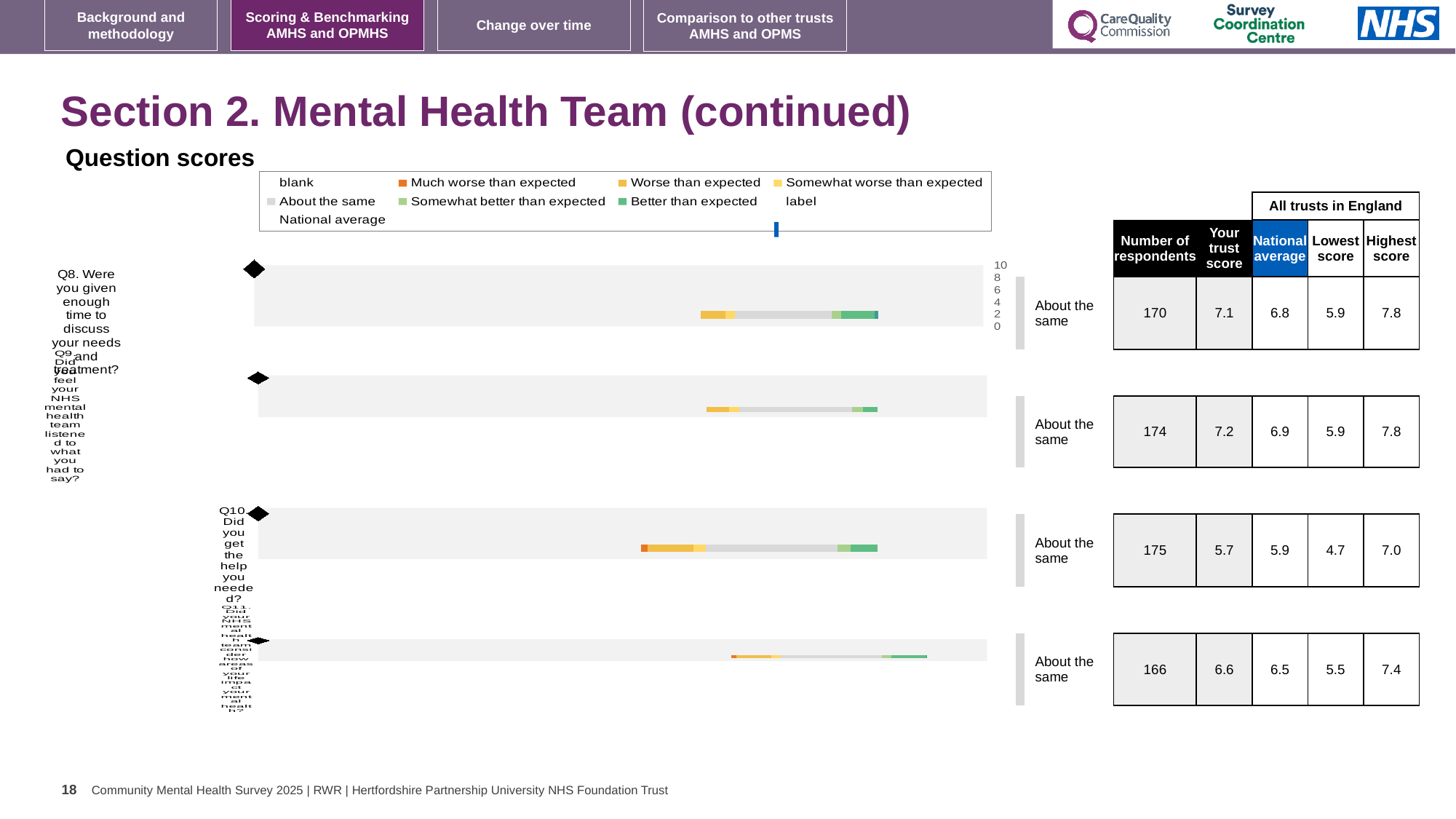
What benchmark label is shown next to the bar for Q8? About the same Which question numbers are plotted in the 'Question scores' chart? Q8, Q9, Q10, Q11 What is the highest tick value shown on the chart's axis? 10 What colour does the legend use for 'Much worse than expected'? orange How many entries does the legend of the 'Question scores' chart list? 9 What benchmark label is shown next to the bar for Q10? About the same What kind of chart is shown under 'Question scores'? bar chart How many questions (categories) are plotted in the 'Question scores' chart? 4